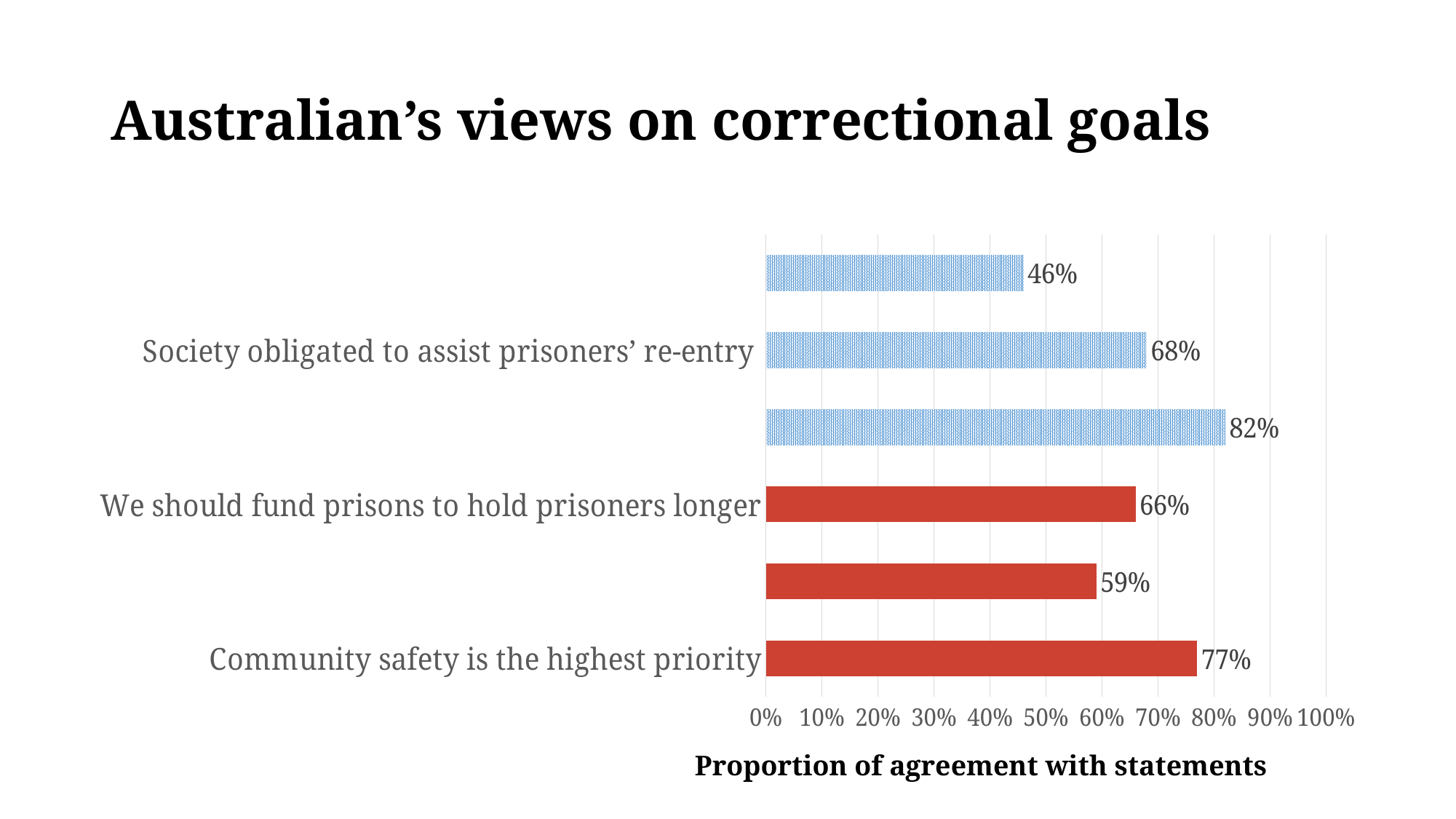
What is the proportion of agreement for "Society obligated to assist prisoners' re-entry"? 68% What is the proportion of agreement for "We should fund prisons to hold prisoners longer"? 66% What is the label on the horizontal axis of the chart? Proportion of agreement with statements Is the value for "We should fund prisons to hold prisoners longer" greater or less than 50%? greater What is the highest value shown on any bar in the chart? 82% What is the lowest value shown on any bar in the chart? 46% How many bars are plotted in the chart? 6 Which has a higher proportion of agreement: "Community safety is the highest priority" or "We should fund prisons to hold prisoners longer"? Community safety is the highest priority What kind of chart is shown on the slide? bar chart What is the proportion of agreement for "Community safety is the highest priority"? 77% What is the difference between the values for "Community safety is the highest priority" and "Society obligated to assist prisoners' re-entry"? 9% What is the title of the slide? Australian's views on correctional goals